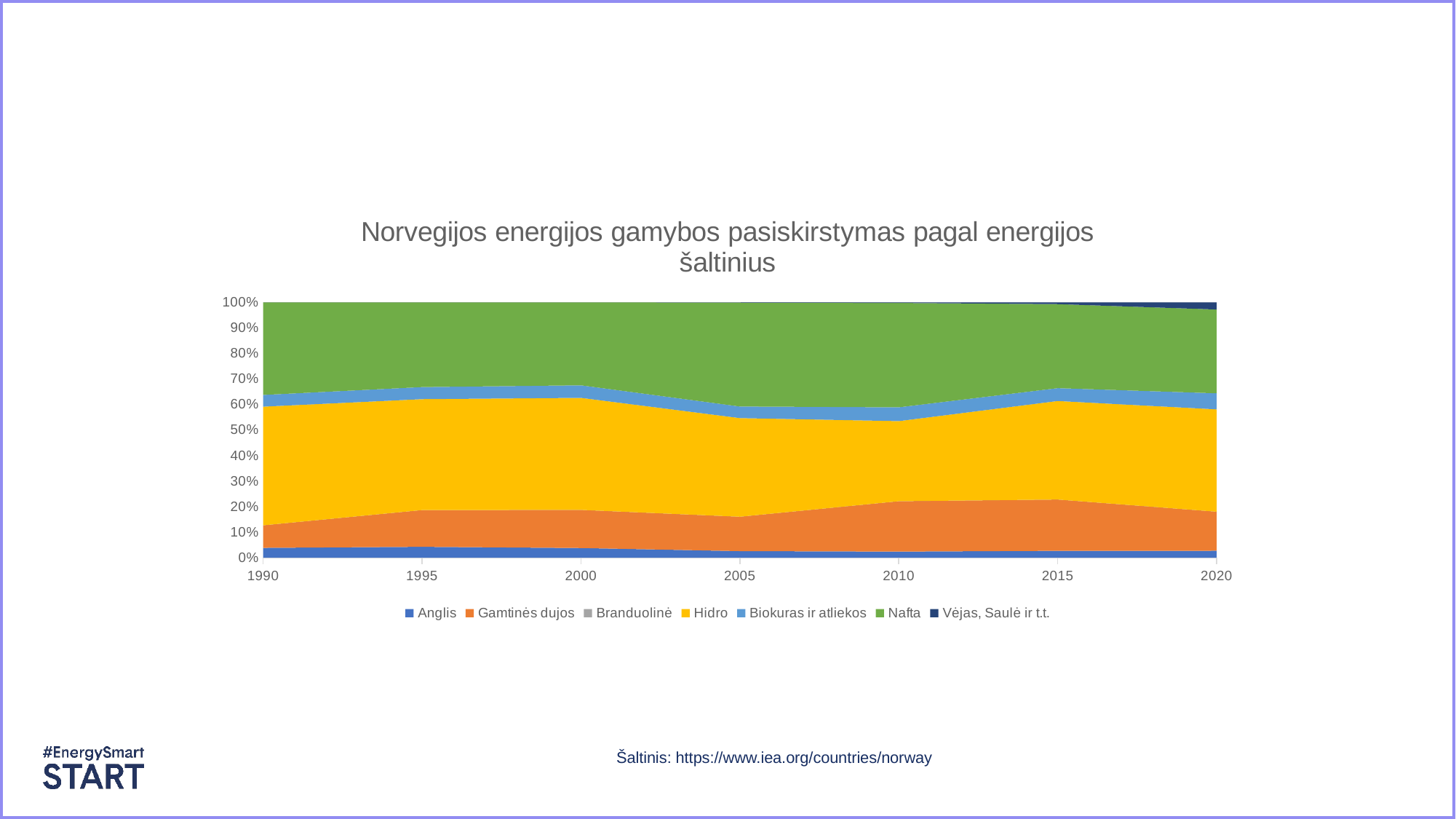
In 2000, which has the larger share, Hidro or Gamtinės dujos? Hidro What is the first year shown on the x axis? 1990 How many years are marked on the x axis? 7 How many series does the legend list? 7 Which series is shown in green? Nafta Is the share of Anglis in 1990 greater or less than 10%? less What kind of chart is shown on the slide? Stacked area chart What is the last year shown on the x axis? 2020 Does the share of Gamtinės dujos rise or fall between 1990 and 2015? rise What is the title of the chart? Norvegijos energijos gamybos pasiskirstymas pagal energijos šaltinius Which energy source has the largest share in 1990? Hidro In 1990, which has the larger share, Nafta or Anglis? Nafta